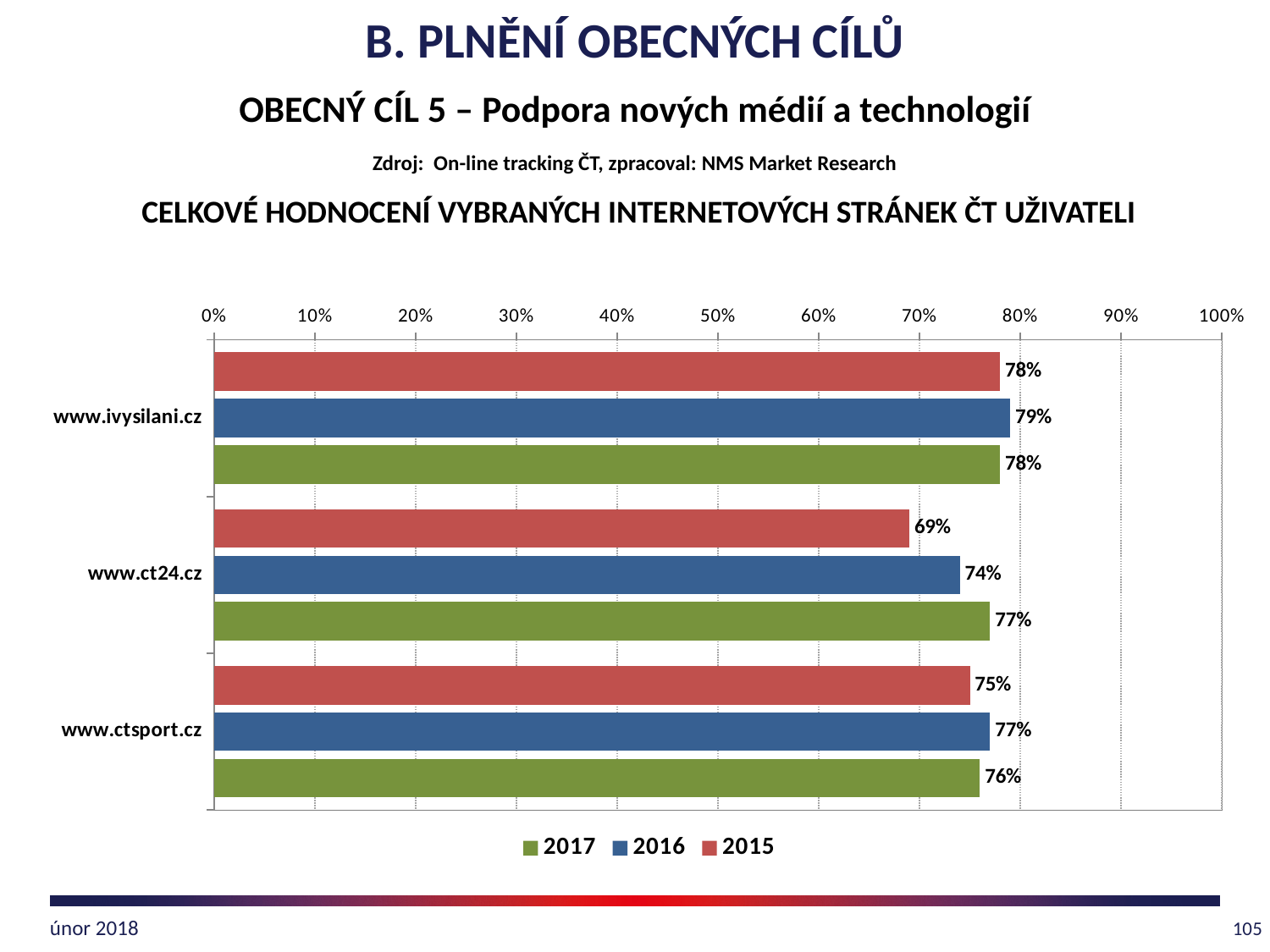
What is the 2017 value for www.ctsport.cz? 76% Which website has the lowest 2015 value? www.ct24.cz Do the values for www.ct24.cz rise or fall from 2015 to 2017? Rise What is the difference between the 2017 and 2015 values for www.ct24.cz? 8% What is the 2016 value for www.ivysilani.cz? 79% What kind of chart is shown on the slide? Bar chart Which is larger for www.ct24.cz: the 2016 value or the 2017 value? 2017 What is the 2015 value for www.ct24.cz? 69% Which website has the highest 2016 value? www.ivysilani.cz Which colour represents the 2015 series in the legend? Red How many series does the legend list? 3 How many websites (categories) are shown on the chart? 3